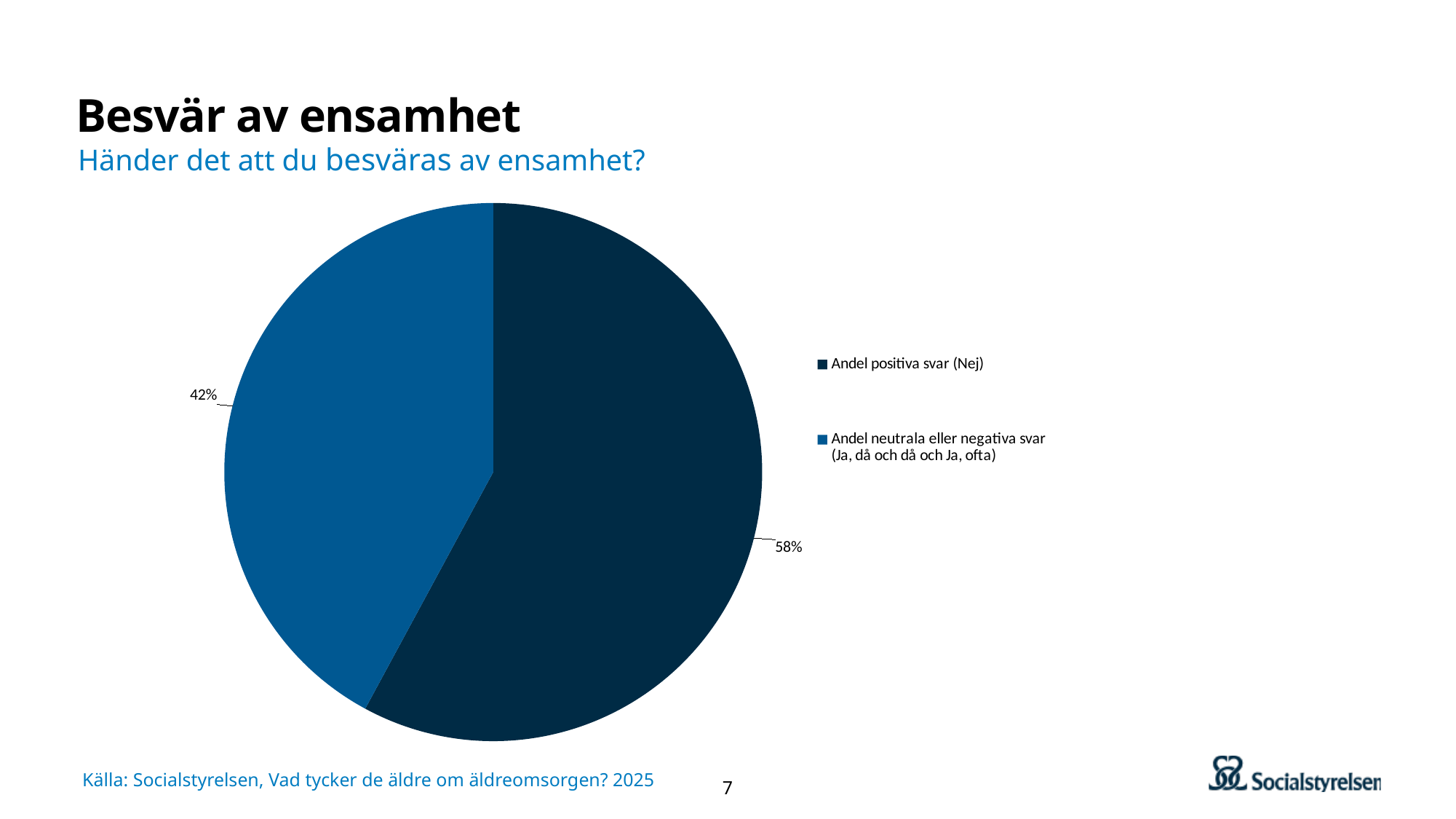
What is the difference in percentage points between the 'Andel positiva svar (Nej)' slice and the 'Andel neutrala eller negativa svar' slice? 16 percentage points How many entries does the legend list? 2 Which slice is the largest? Andel positiva svar (Nej) What share of the pie is 'Andel positiva svar (Nej)'? 58% What share of the pie is 'Andel neutrala eller negativa svar (Ja, då och då och Ja, ofta)'? 42% Which slice is the smallest? Andel neutrala eller negativa svar (Ja, då och då och Ja, ofta) What question is the chart based on, as shown in the subtitle? Händer det att du besväras av ensamhet? What is the title of the slide containing the chart? Besvär av ensamhet What kind of chart is shown on the slide? pie chart How many slices does the pie chart have? 2 Which is larger: the share for 'Andel positiva svar (Nej)' or the share for 'Andel neutrala eller negativa svar'? Andel positiva svar (Nej)